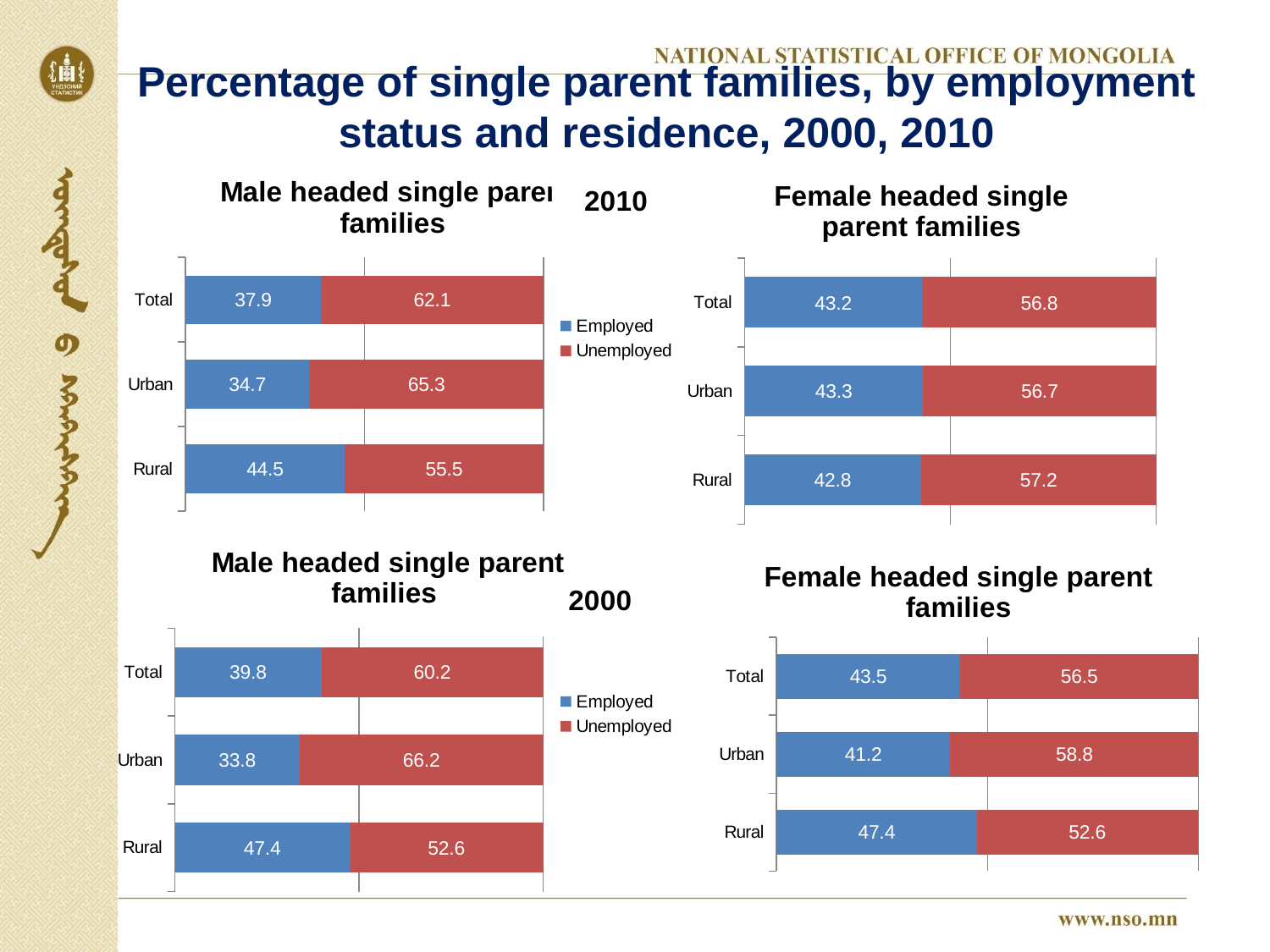
In the top-left chart (Male headed single parent families, 2010), what is the Employed value for Rural? 44.5 In the bottom-left chart (Male headed single parent families, 2000), which category has the lowest Employed value? Urban In the bottom-right chart (Female headed single parent families, 2000), what is the Employed value for Urban? 41.2 How many series does the legend list for the top-left chart (Male headed single parent families, 2010)? 2 How many categories are shown in the bottom-left chart (Male headed single parent families, 2000)? 3 In the top-right chart (Female headed single parent families, 2010), is the Employed value for Urban larger or smaller than the Employed value for Rural? larger In the top-left chart (Male headed single parent families, 2010), what is the difference between the Unemployed values for Urban and Rural? 9.8 In the bottom-left chart (Male headed single parent families, 2000), what is the Unemployed value for Urban? 66.2 In the top-right chart (Female headed single parent families, 2010), what is the Unemployed value for Total? 56.8 In the bottom-right chart (Female headed single parent families, 2000), what is the difference between the Unemployed and Employed values for Rural? 5.2 In the top-left chart (Male headed single parent families, 2010), which category has the highest Employed value? Rural What type of chart is the bottom-right chart (Female headed single parent families, 2000)? Stacked bar chart